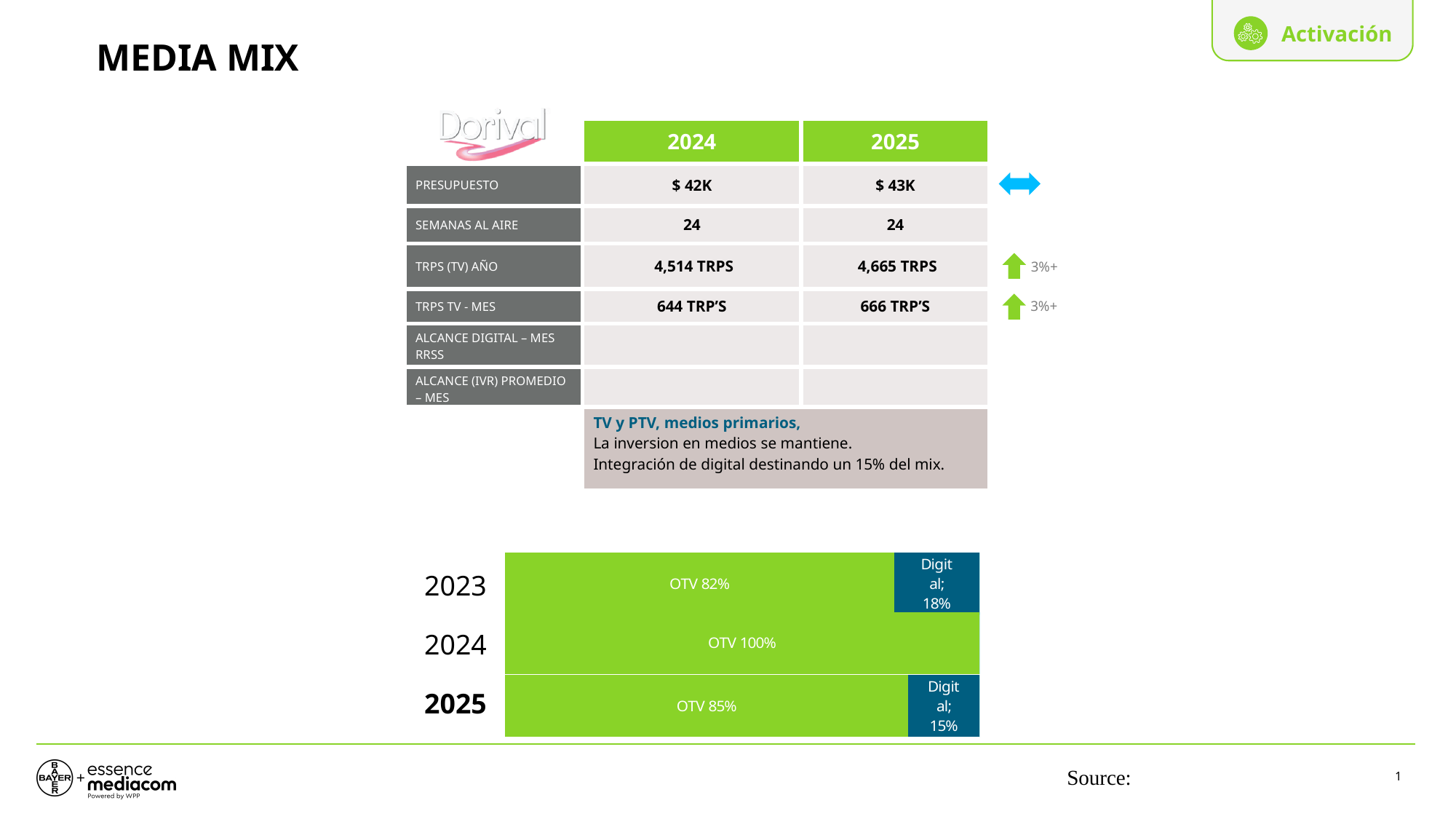
What is the OTV share for 2025 in the bar chart? 85% What is the difference between the Digital share in 2023 and in 2025? 3% What is the OTV share for 2023 in the bar chart? 82% What is the Digital share for 2025 in the bar chart? 15% What kind of chart is shown at the bottom of the slide? Stacked bar chart Which year has the lowest OTV share in the bar chart? 2023 What is the OTV share for 2024 in the bar chart? 100% What is the Digital share for 2023 in the bar chart? 18% What is the total of the 2025 bar (OTV plus Digital)? 100% Which year has the highest OTV share in the bar chart? 2024 How many years are shown in the bar chart? 3 Is the OTV share larger in 2023 or in 2025? 2025